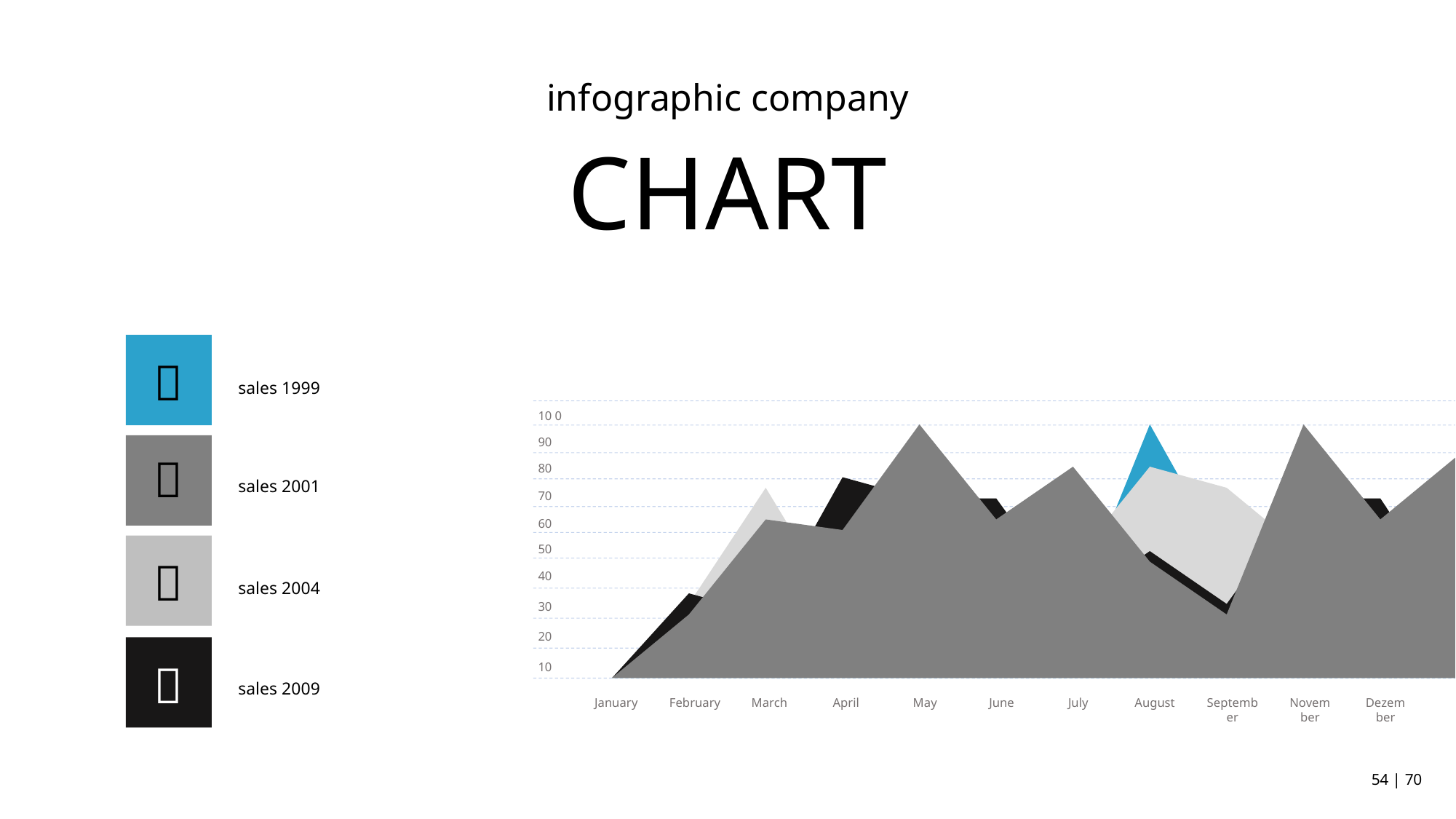
Does the sales 2001 series rise or fall from January to May? rise What kind of chart is shown on the slide? area chart Is the value for sales 2004 in March greater or less than 60? greater Is the value for sales 2001 in May greater or less than 80? greater In which month is the sales 2001 series at its lowest? January Is the value for sales 2001 in January greater or less than 20? less How many series does the legend list? 4 How many months are labelled along the x axis? 11 Which colour represents sales 1999 in the legend? blue What is the large title text above the chart? CHART